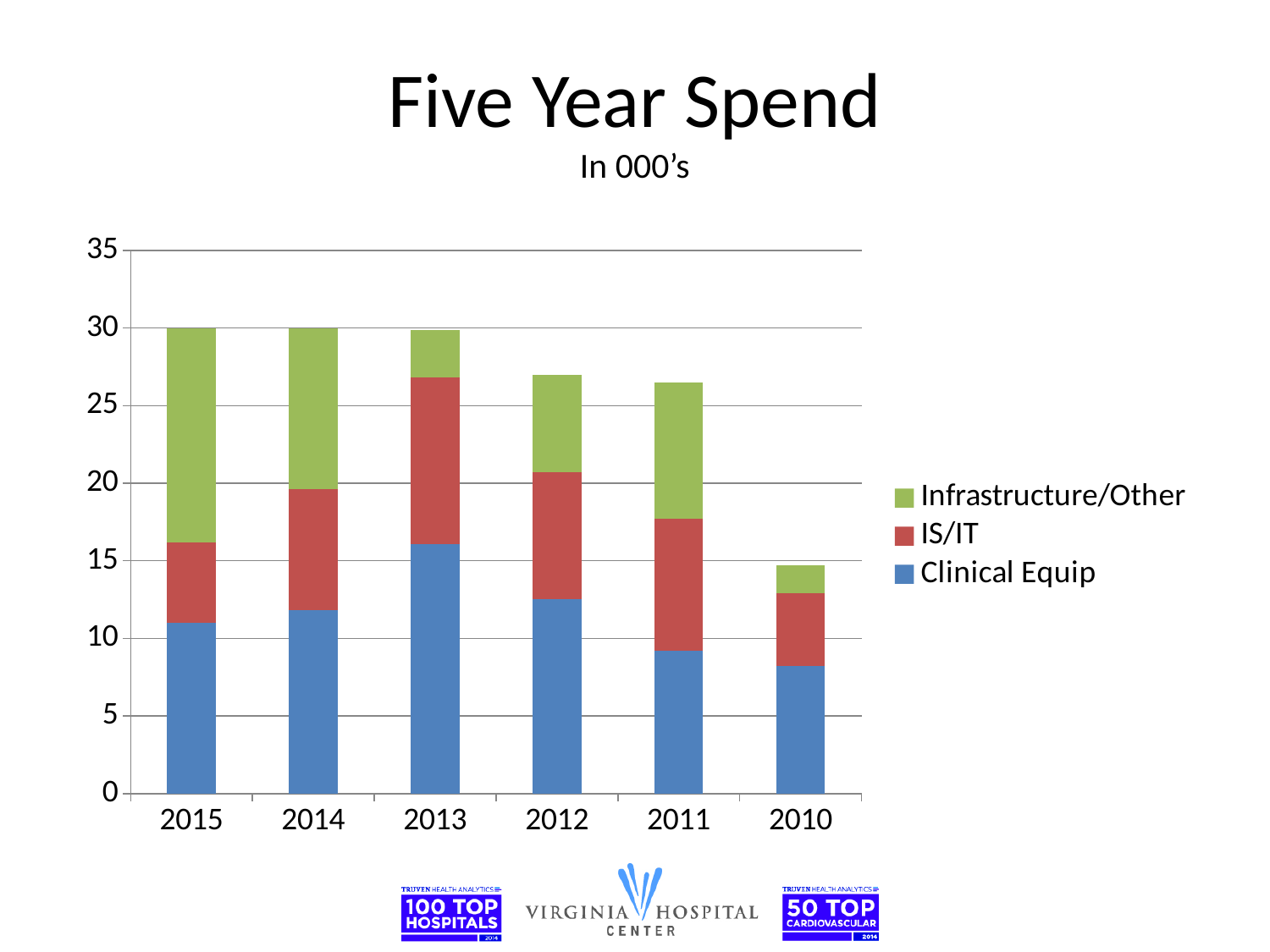
How many series does the chart's legend list? 3 How many years are shown on the x axis of the chart? 6 Is the total spend for 2012 greater or less than 25? greater Which year has the lowest total spend? 2010 Which year has the highest Clinical Equip spend? 2013 Is the Clinical Equip value for 2011 greater or less than 10? less What is the title of the chart? Five Year Spend Is the total spend for 2010 greater or less than 10? greater Which is larger, the Infrastructure/Other segment for 2015 or for 2013? 2015 What kind of chart is shown on the slide? Stacked bar chart Do the total bar heights generally rise or fall moving from left to right along the x axis? fall